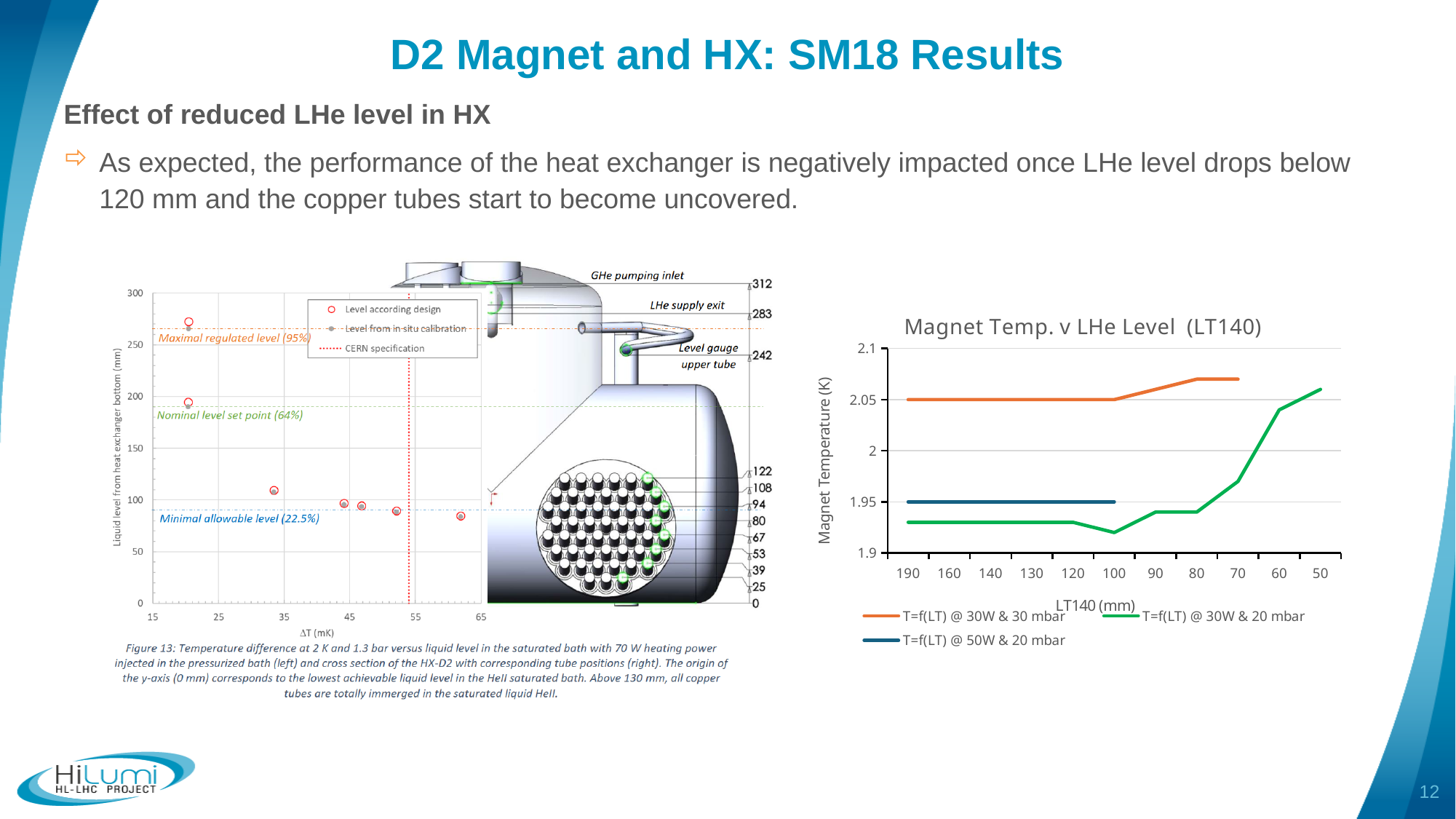
In the 'Magnet Temp. v LHe Level (LT140)' chart, is the value of the 'T=f(LT) @ 30W & 30 mbar' series at LT140 = 70 greater or less than 2.05? greater What kind of chart is the left chart (Figure 13) showing liquid level versus ΔT? scatter chart How many entries does the legend of the left chart (Figure 13) list? 3 What kind of chart is the 'Magnet Temp. v LHe Level (LT140)' chart on the right? line chart In the 'Magnet Temp. v LHe Level (LT140)' chart, is the value of the 'T=f(LT) @ 50W & 20 mbar' series at LT140 = 190 greater or less than 2? less In the 'Magnet Temp. v LHe Level (LT140)' chart, is the value of the 'T=f(LT) @ 30W & 20 mbar' series at LT140 = 190 greater or less than 1.95? less How many series does the legend of the 'Magnet Temp. v LHe Level (LT140)' chart list? 3 In the 'Magnet Temp. v LHe Level (LT140)' chart, which series has the higher value at LT140 = 190: 'T=f(LT) @ 30W & 30 mbar' or 'T=f(LT) @ 30W & 20 mbar'? T=f(LT) @ 30W & 30 mbar How many LT140 values are marked along the x axis of the 'Magnet Temp. v LHe Level (LT140)' chart? 11 In the 'Magnet Temp. v LHe Level (LT140)' chart, does the 'T=f(LT) @ 30W & 20 mbar' series rise or fall as you move from LT140 = 90 to LT140 = 50 along the x axis? rise In the 'Magnet Temp. v LHe Level (LT140)' chart, what is the y-axis label? Magnet Temperature (K)